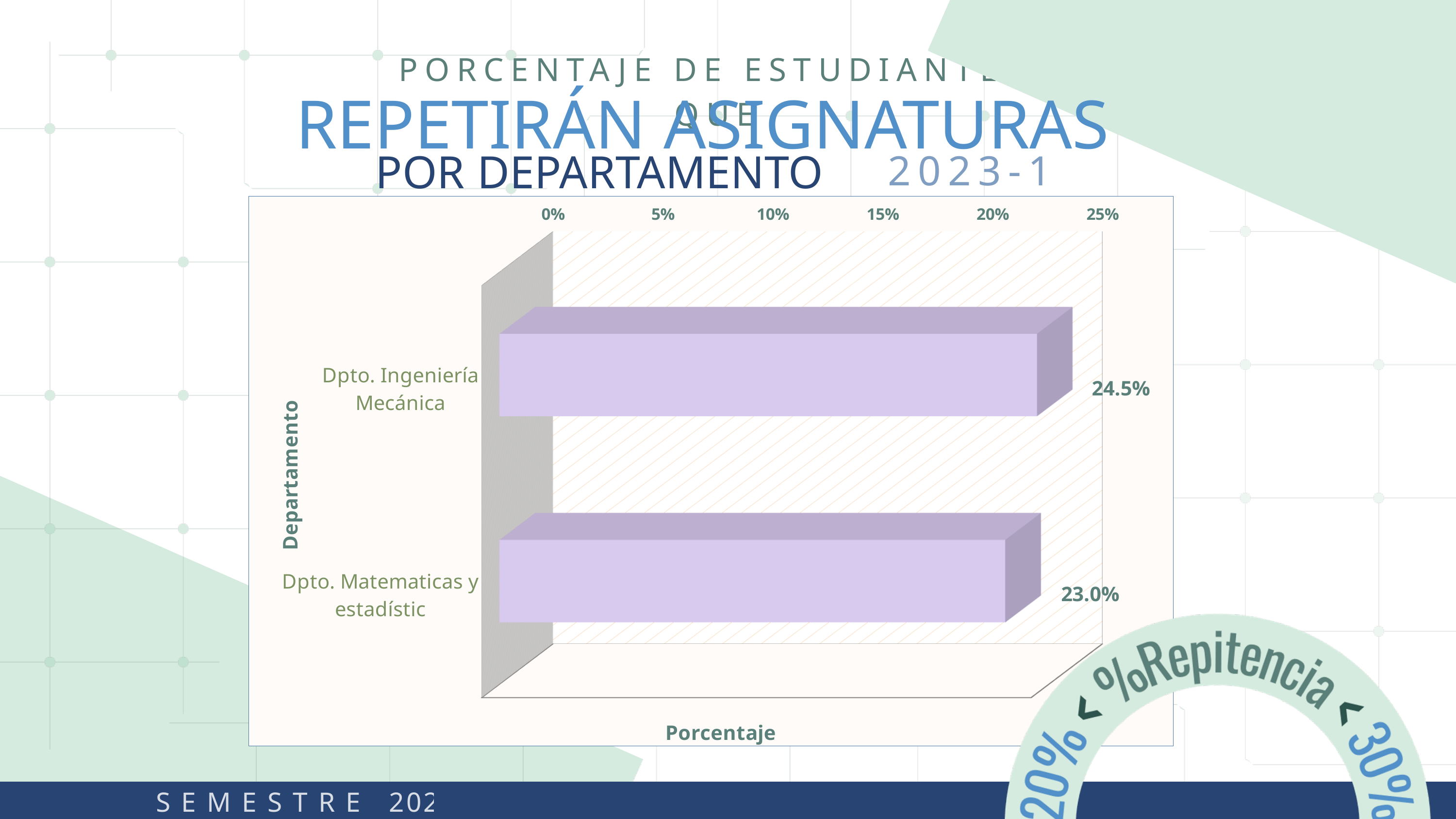
Is the value for Dpto. Matematicas y estadístic greater or less than 20%? greater What is the value for Dpto. Ingeniería Mecánica? 24.5% How many departments are shown in the chart? 2 What is the title of the horizontal axis of the chart? Porcentaje Is the value for Dpto. Ingeniería Mecánica greater or less than 25%? less Which is larger, the value for Dpto. Ingeniería Mecánica or the value for Dpto. Matematicas y estadístic? Dpto. Ingeniería Mecánica What kind of chart is shown on the slide? Bar chart Which department has the highest percentage? Dpto. Ingeniería Mecánica Which department has the lowest percentage? Dpto. Matematicas y estadístic What is the value for Dpto. Matematicas y estadístic? 23.0% What is the title of the vertical axis of the chart? Departamento What is the difference between the values for Dpto. Ingeniería Mecánica and Dpto. Matematicas y estadístic? 1.5%